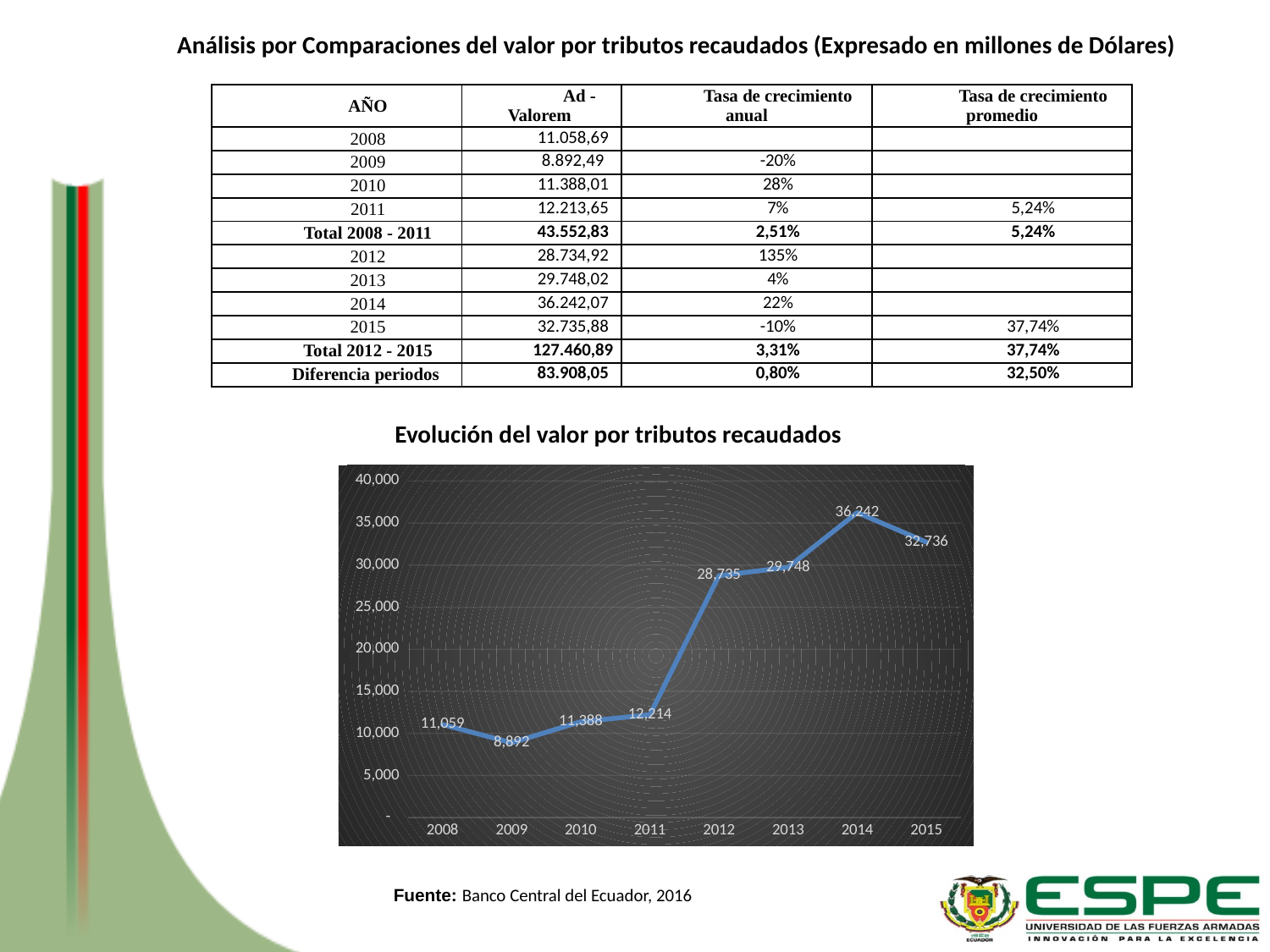
In the chart 'Evolución del valor por tributos recaudados', what is the difference between the values for 2014 and 2015? 3,506 In the chart 'Evolución del valor por tributos recaudados', what is the value for 2015? 32,736 How many years are plotted in the chart 'Evolución del valor por tributos recaudados'? 8 In the chart 'Evolución del valor por tributos recaudados', what is the difference between the values for 2012 and 2011? 16,521 What kind of chart is shown under the title 'Evolución del valor por tributos recaudados'? Line chart In the chart 'Evolución del valor por tributos recaudados', which year has the lowest value? 2009 In the chart 'Evolución del valor por tributos recaudados', what is the value for 2009? 8,892 In the chart 'Evolución del valor por tributos recaudados', what is the value for 2012? 28,735 In the chart 'Evolución del valor por tributos recaudados', do the values rise or fall from 2011 to 2014? Rise In the chart 'Evolución del valor por tributos recaudados', is the value for 2013 greater or less than 25,000? greater In the chart 'Evolución del valor por tributos recaudados', which is larger, the value for 2010 or the value for 2011? 2011 In the chart 'Evolución del valor por tributos recaudados', which year has the highest value? 2014